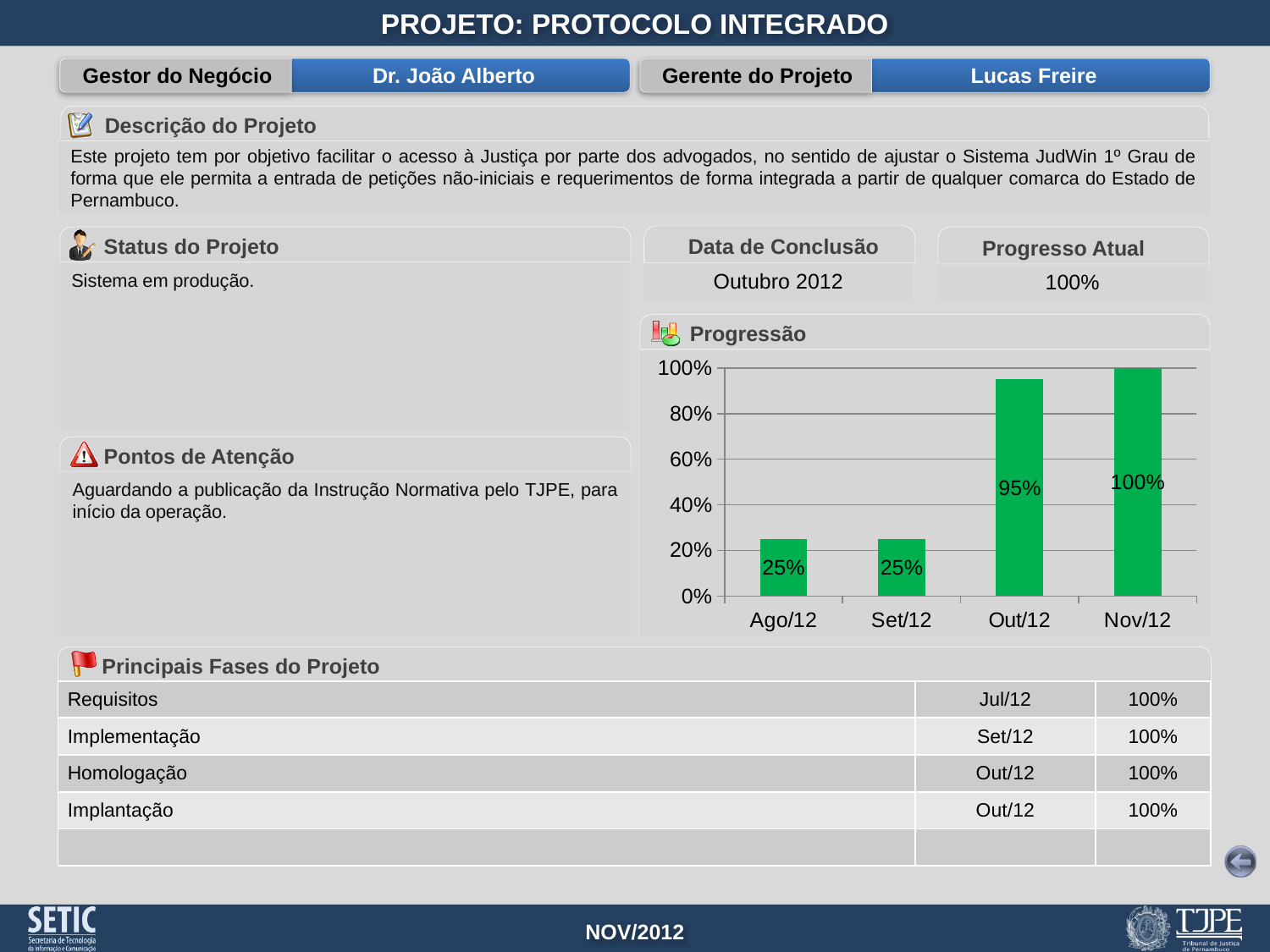
What is the difference between the values for Out/12 and Set/12 in the Progressão chart? 70% What is the value for Nov/12 in the Progressão chart? 100% What kind of chart is the Progressão chart? bar chart What is the value for Out/12 in the Progressão chart? 95% How many months are shown on the x axis of the Progressão chart? 4 Which is larger in the Progressão chart, the value for Set/12 or the value for Out/12? Out/12 Which month has the highest value in the Progressão chart? Nov/12 Is the value for Out/12 in the Progressão chart greater or less than 80%? greater Do the values in the Progressão chart rise or fall from Ago/12 to Nov/12? rise What is the difference between the values for Nov/12 and Out/12 in the Progressão chart? 5% What is the value for Ago/12 in the Progressão chart? 25% What is the title of the chart on the slide? Progressão